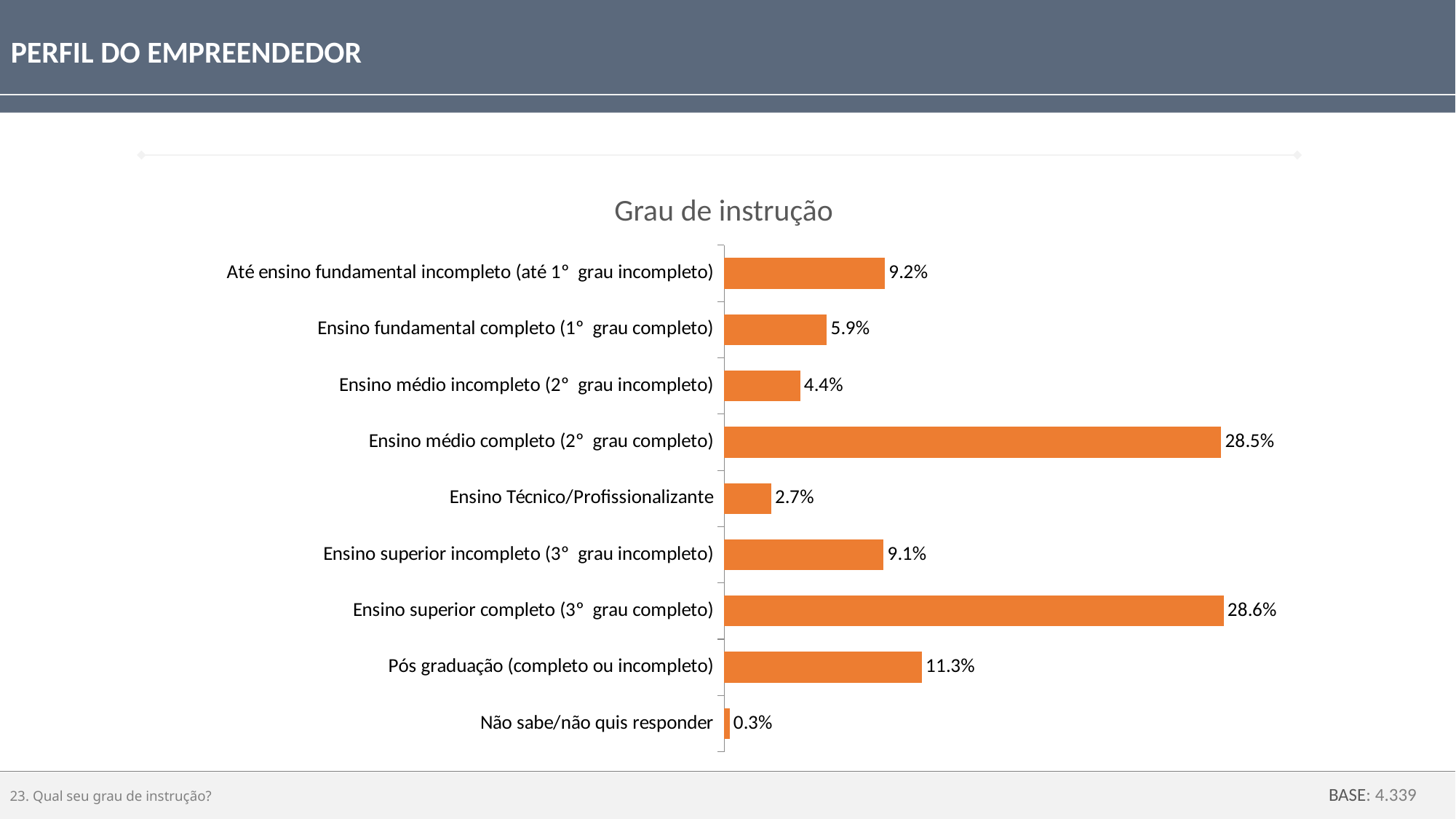
What kind of chart is shown on the slide? Bar chart What is the value for Ensino Técnico/Profissionalizante? 2.7% What is the value for Até ensino fundamental incompleto (até 1° grau incompleto)? 9.2% Which category has the lowest value? Não sabe/não quis responder What is the difference between Ensino fundamental completo (1° grau completo) and Ensino médio incompleto (2° grau incompleto)? 1.5% Which is larger: Pós graduação (completo ou incompleto) or Ensino fundamental completo (1° grau completo)? Pós graduação (completo ou incompleto) What is the value for Pós graduação (completo ou incompleto)? 11.3% What is the title of the chart? Grau de instrução How many categories are shown in the chart? 9 Which category has the highest value according to the data labels? Ensino superior completo (3° grau completo) What is the value for Ensino médio completo (2° grau completo)? 28.5% What is the difference between Ensino superior completo (3° grau completo) and Ensino superior incompleto (3° grau incompleto)? 19.5%